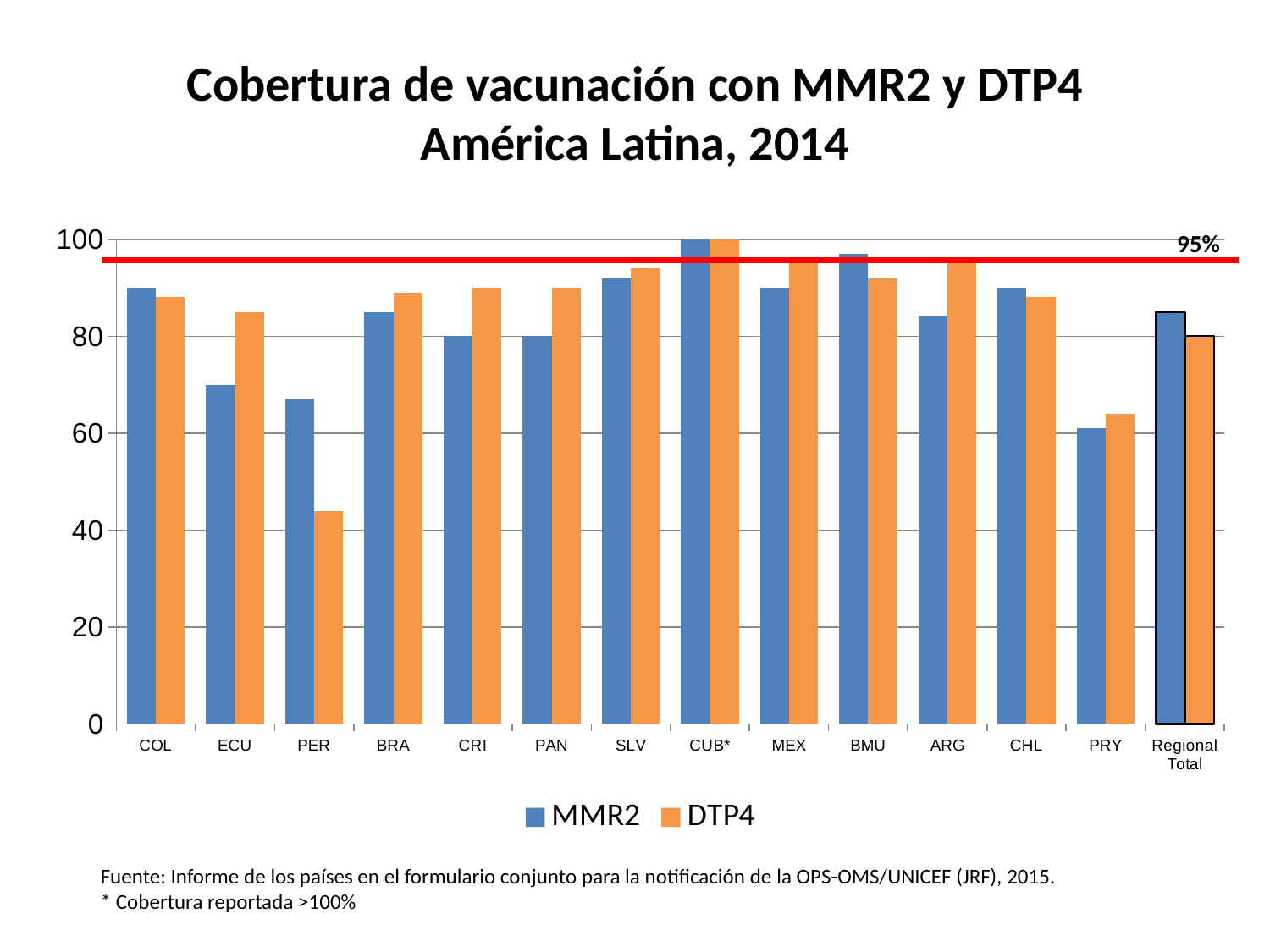
What kind of chart is shown on the slide? bar chart How many categories are shown on the x axis, including Regional Total? 14 Which country has the highest MMR2 coverage? CUB* Is the DTP4 value for PER greater or less than 60? less Is the MMR2 value for ECU greater or less than 80? less How many series does the legend list? 2 Which country has the lowest MMR2 coverage? PRY What are the two series named in the legend? MMR2 and DTP4 Is the DTP4 value for MEX greater or less than 80? greater For ARG, which is larger, the MMR2 value or the DTP4 value? DTP4 Which country has the lowest DTP4 coverage? PER What percentage is marked by the red horizontal line? 95%